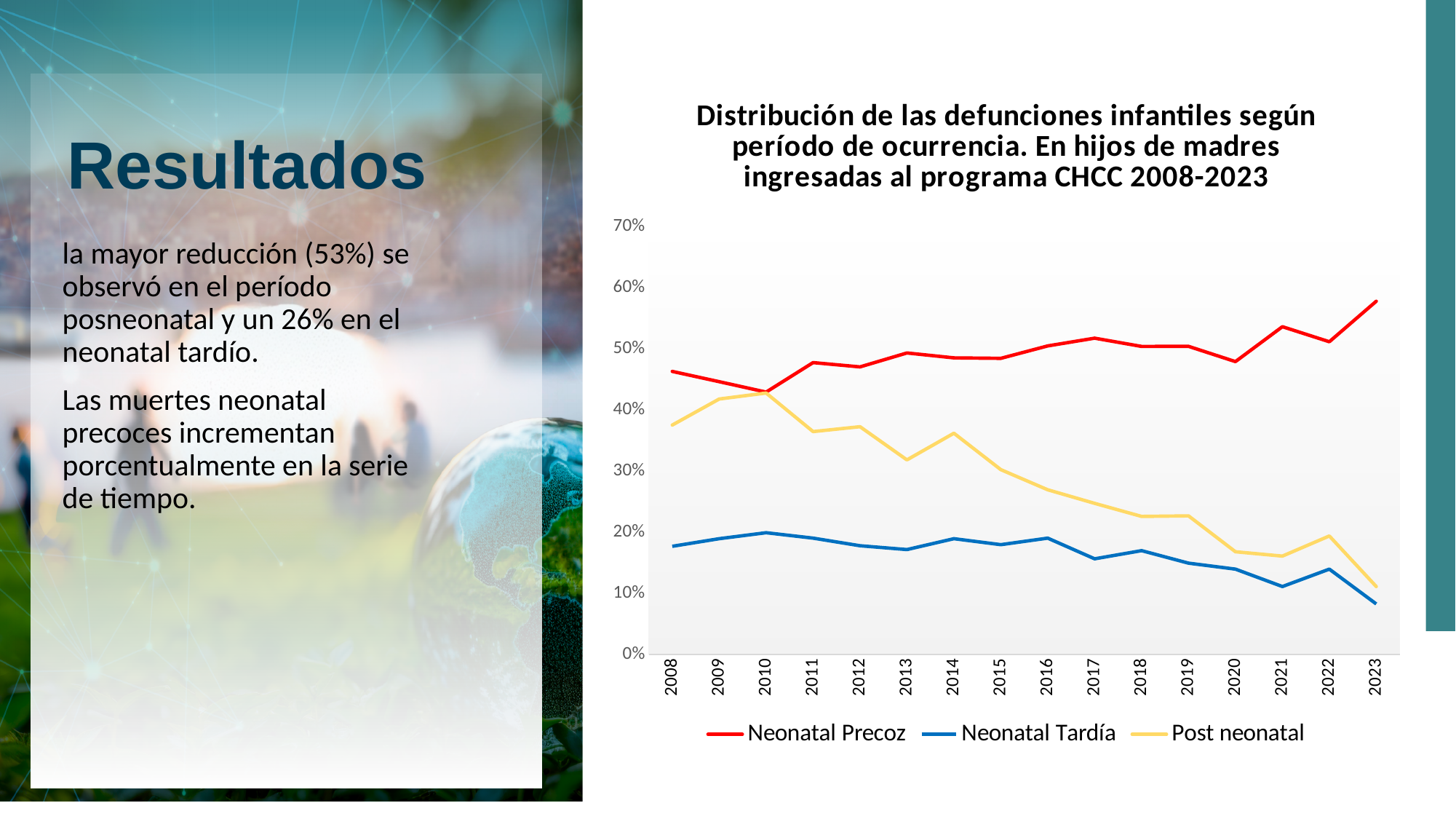
How many years are plotted along the x axis? 16 Does the Neonatal Precoz series generally rise or fall from 2008 to 2023? rise How many series does the legend list? 3 What colour is the Neonatal Tardía line? blue In 2008, which is larger: Neonatal Precoz or Post neonatal? Neonatal Precoz Is the value for Neonatal Tardía in 2008 greater or less than 20%? less What kind of chart is shown on the slide? line chart In which year does the Post neonatal series reach its lowest value? 2023 Does the Post neonatal series generally rise or fall from 2008 to 2023? fall Is the value for Post neonatal in 2023 greater or less than 20%? less Is the value for Neonatal Precoz in 2023 greater or less than 50%? greater Which series has the highest value in 2023? Neonatal Precoz